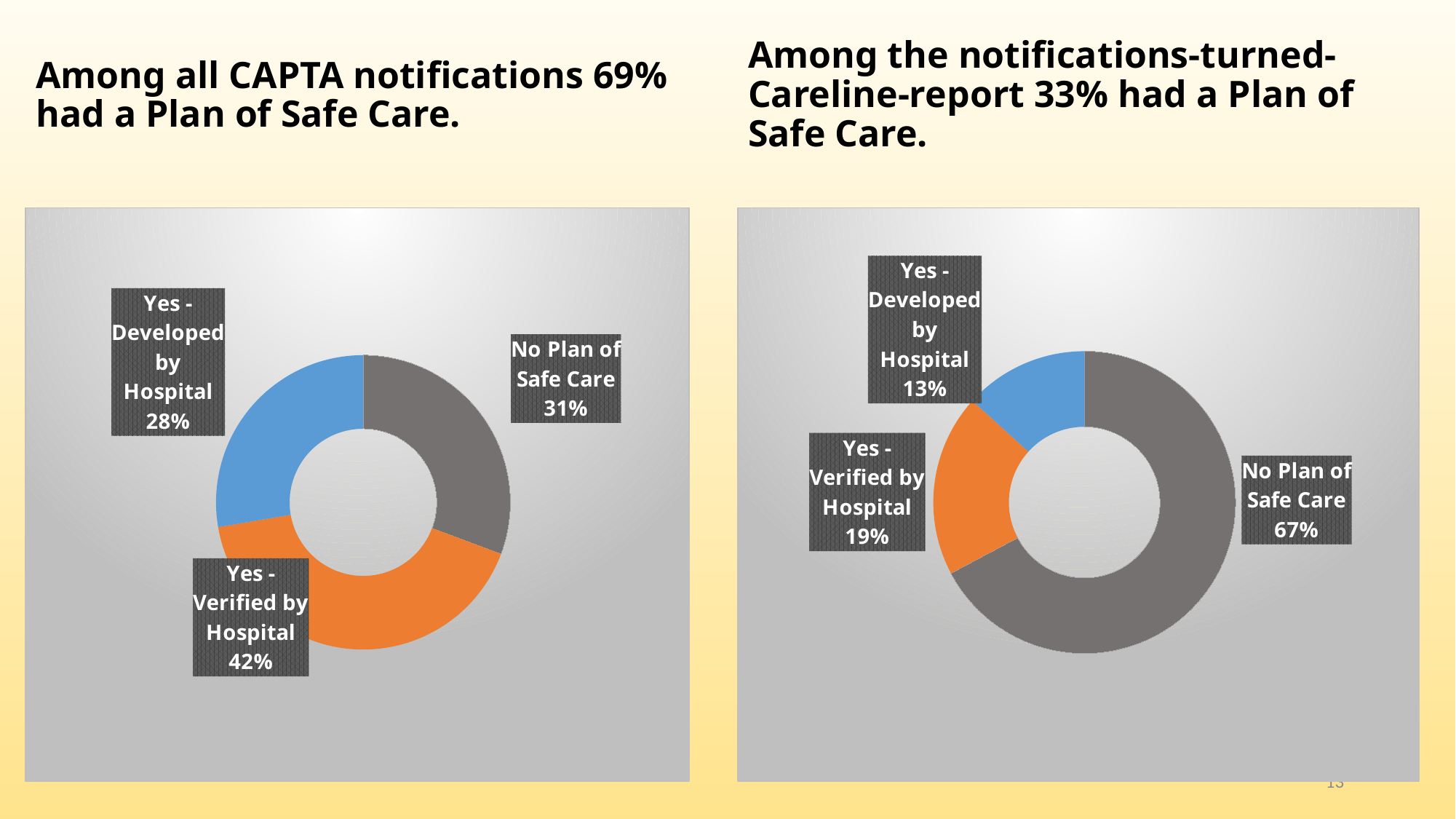
In the left chart (all CAPTA notifications), what share is labelled 'No Plan of Safe Care'? 31% In the right chart (notifications-turned-Careline-report), which category has the smallest share? Yes - Developed by Hospital In the left chart (all CAPTA notifications), which is larger: 'Yes - Developed by Hospital' or 'No Plan of Safe Care'? No Plan of Safe Care How many categories does the right chart (notifications-turned-Careline-report) show? 3 In the right chart (notifications-turned-Careline-report), what share is labelled 'Yes - Verified by Hospital'? 19% In the left chart (all CAPTA notifications), what share is labelled 'Yes - Developed by Hospital'? 28% In the right chart (notifications-turned-Careline-report), what is the difference between the 'No Plan of Safe Care' share and the 'Yes - Verified by Hospital' share? 48% In the right chart (notifications-turned-Careline-report), what share is labelled 'No Plan of Safe Care'? 67% In the left chart (all CAPTA notifications), what share is labelled 'Yes - Verified by Hospital'? 42% In the right chart (notifications-turned-Careline-report), what share is labelled 'Yes - Developed by Hospital'? 13% What kind of chart is the left chart (all CAPTA notifications)? Doughnut (pie) chart In the left chart (all CAPTA notifications), which category has the largest share? Yes - Verified by Hospital